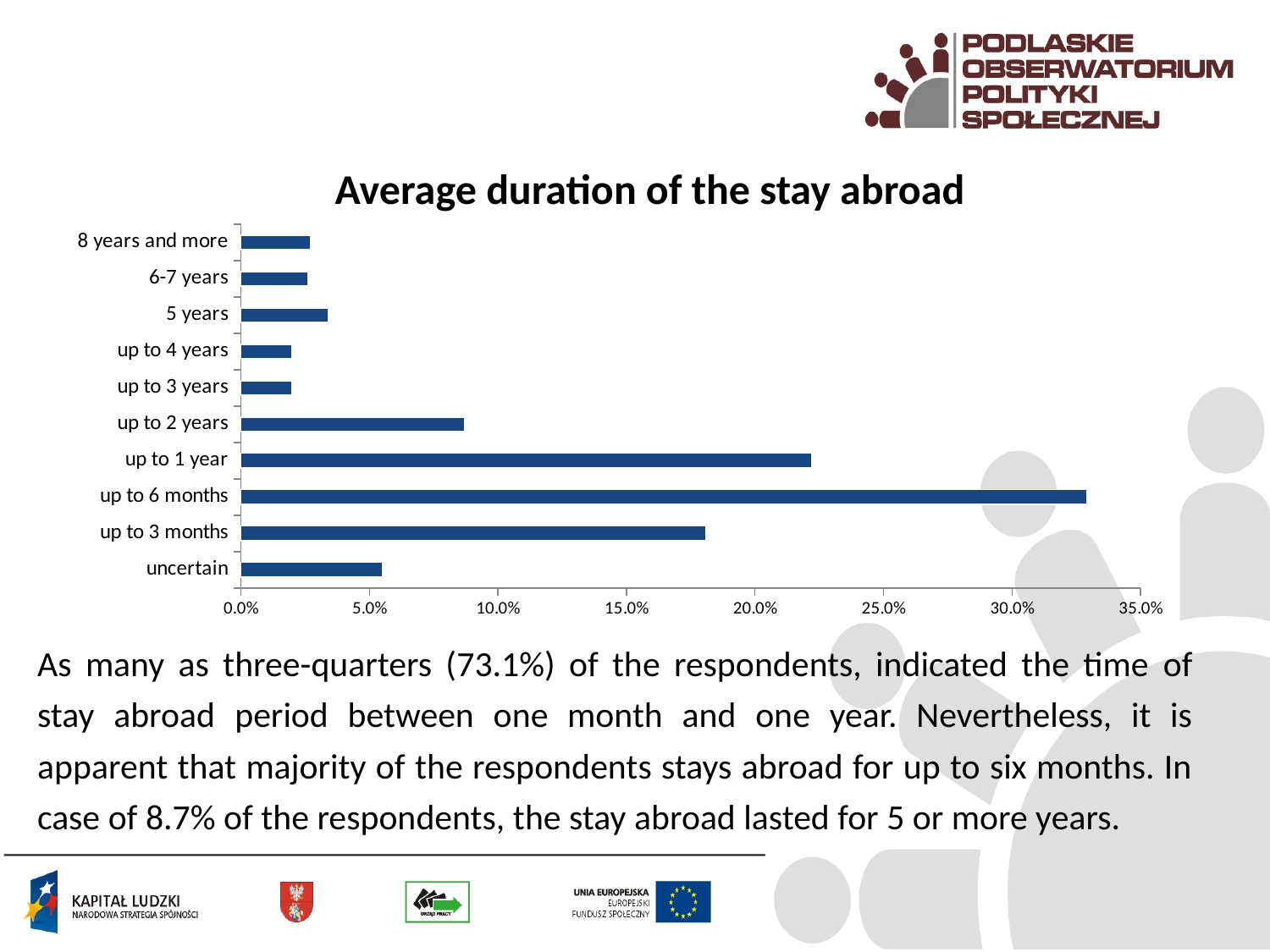
Which is larger, the value for 'up to 2 years' or the value for '5 years'? up to 2 years What kind of chart is shown on the slide? bar chart What is the maximum value shown on the horizontal axis? 35.0% Is the value for '5 years' greater or less than 5.0%? less Which is larger, the value for 'up to 1 year' or the value for 'up to 3 months'? up to 1 year Is the value for 'up to 2 years' greater or less than 10.0%? less What is the title of the chart? Average duration of the stay abroad Is the value for 'up to 6 months' greater or less than 30.0%? greater Which category has the highest value? up to 6 months How many categories are shown on the chart? 10